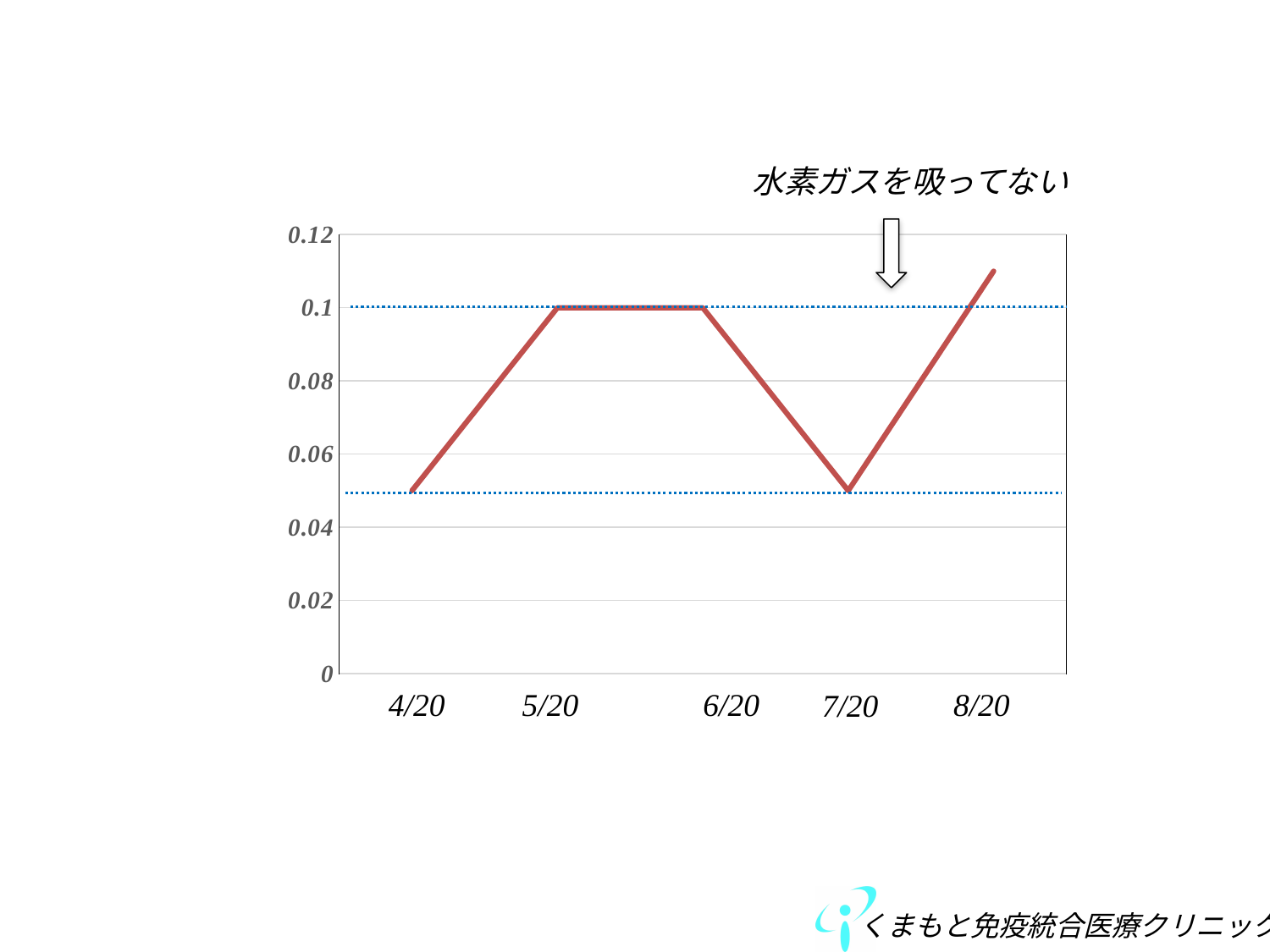
Is the value for 8/20 greater or less than 0.12? less How many date labels are shown on the x axis? 5 Is the value for 8/20 greater or less than 0.1? greater What does the annotation text above the arrow on the chart say? 水素ガスを吸ってない What kind of chart is shown on the slide? line chart Which is larger, the value for 4/20 or the value for 8/20? 8/20 Does the line rise or fall between 7/20 and 8/20? rise What is the value plotted for 5/20? 0.1 Is the value for 7/20 greater or less than 0.06? less Which is larger, the value for 5/20 or the value for 7/20? 5/20 Which date has the highest plotted value? 8/20